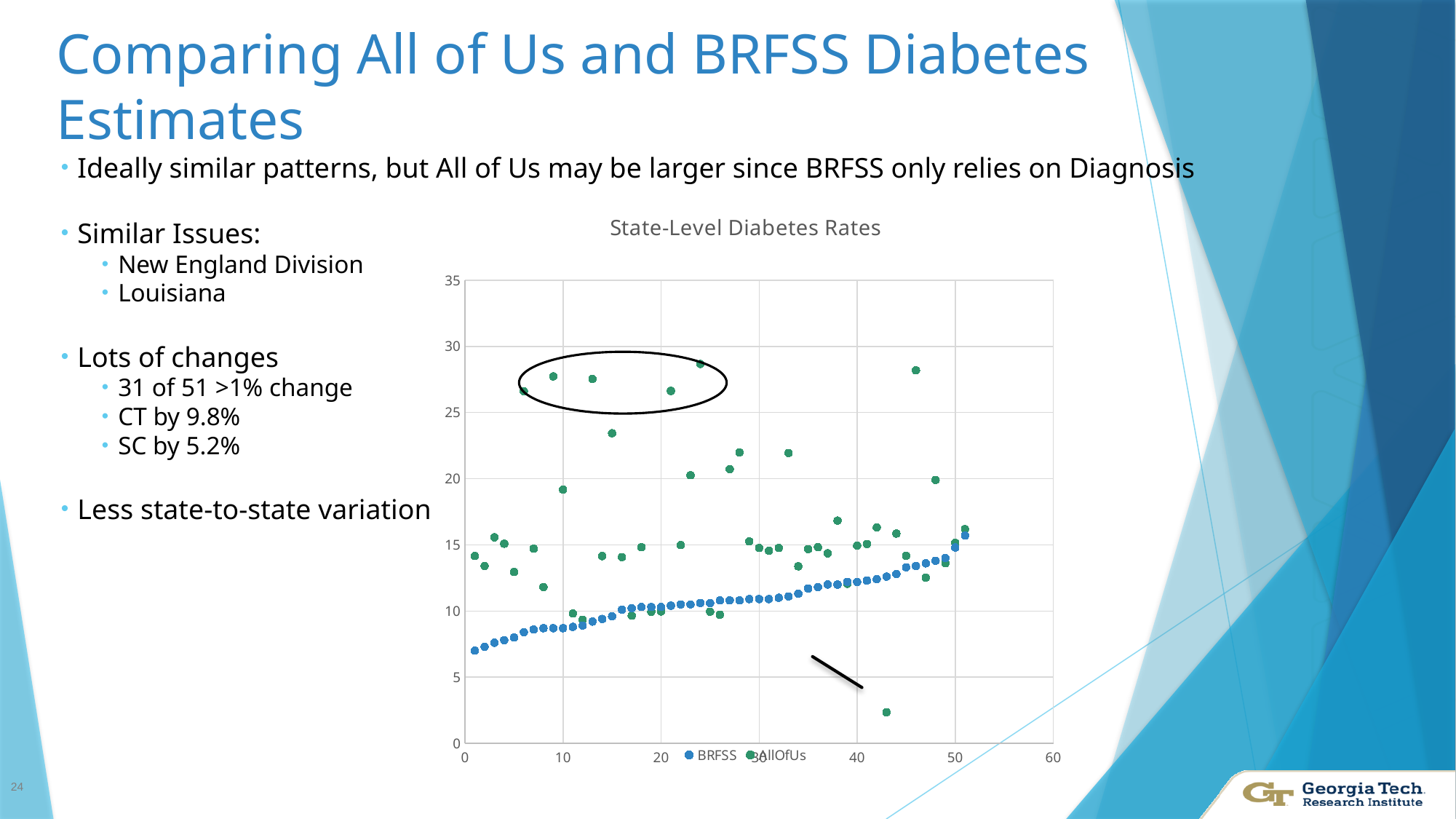
Is the BRFSS value at x = 1 greater or less than 10? less What is the title of the chart? State-Level Diabetes Rates Which series contains the highest plotted value, BRFSS or AllOfUs? AllOfUs Is the highest AllOfUs value greater or less than 25? greater Is the BRFSS value at x = 50 greater or less than 10? greater What are the two series named in the chart legend? BRFSS and AllOfUs Do the BRFSS values rise or fall as the x axis increases? Rise Which series contains the lowest plotted value, BRFSS or AllOfUs? AllOfUs How many series does the chart's legend list? 2 What kind of chart is shown on the slide? Scatter chart